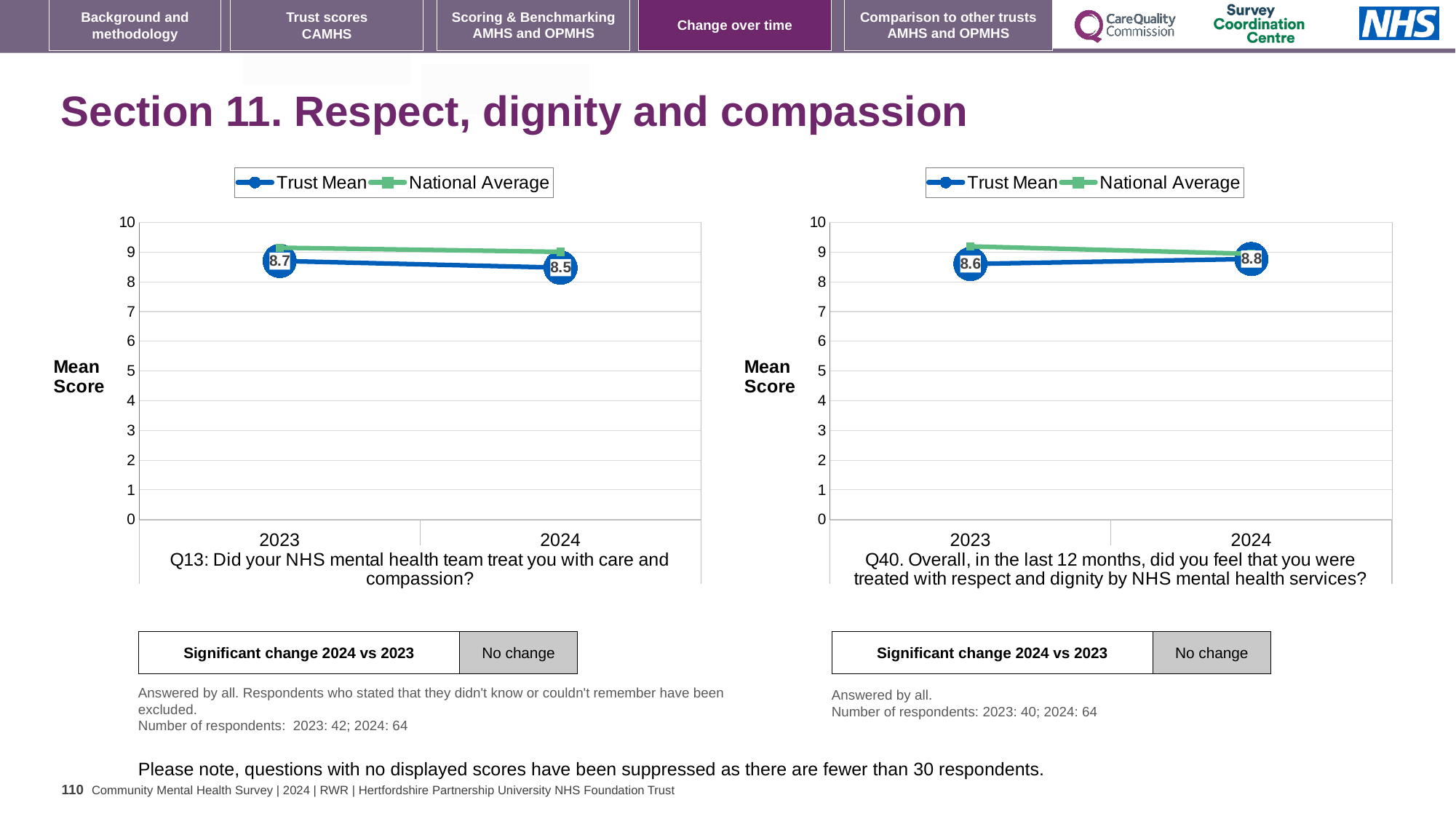
What type of chart is the left chart (Q13)? line chart In the right chart (Q40), what is the Trust Mean score for 2024? 8.8 In the right chart (Q40), which year has the higher Trust Mean, 2023 or 2024? 2024 In the left chart (Q13), what is the Trust Mean score for 2024? 8.5 In the left chart (Q13), does the Trust Mean rise or fall from 2023 to 2024? fall How many years are plotted on the x axis of the right chart (Q40)? 2 In the left chart (Q13), is the National Average for 2023 greater or less than 8? greater How many series does the legend of the right chart (Q40) list? 2 In the left chart (Q13), what is the Trust Mean score for 2023? 8.7 In the right chart (Q40), does the Trust Mean rise or fall from 2023 to 2024? rise In the right chart (Q40), what is the Trust Mean score for 2023? 8.6 In the left chart (Q13), by how much did the Trust Mean change from 2023 to 2024? 0.2